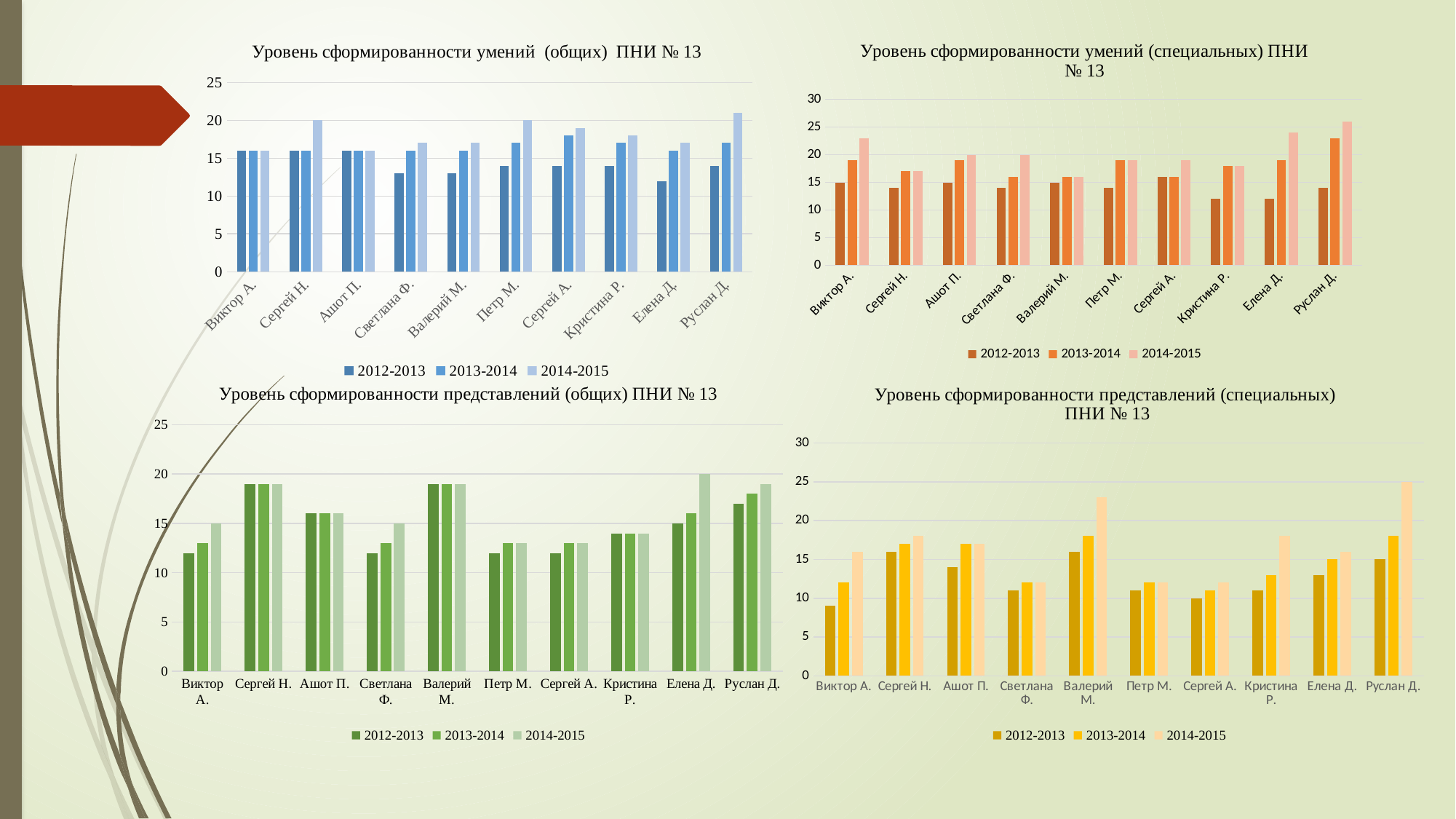
How many series does the legend of the top-right chart "Уровень сформированности умений (специальных) ПНИ № 13" list? 3 What are the three legend entries of the bottom-left chart "Уровень сформированности представлений (общих) ПНИ № 13"? 2012-2013, 2013-2014, 2014-2015 In the top-right chart "Уровень сформированности умений (специальных) ПНИ № 13", is the 2014-2015 value for Руслан Д. greater or less than 25? greater What kind of chart is the top-left chart titled "Уровень сформированности умений (общих) ПНИ № 13"? Bar chart In the bottom-right chart "Уровень сформированности представлений (специальных) ПНИ № 13", is the 2014-2015 value for Валерий М. greater or less than 20? greater In the bottom-right chart "Уровень сформированности представлений (специальных) ПНИ № 13", which person has the highest 2014-2015 value? Руслан Д. In the bottom-right chart "Уровень сформированности представлений (специальных) ПНИ № 13", is the 2012-2013 value for Виктор А. greater or less than 10? less In the top-right chart "Уровень сформированности умений (специальных) ПНИ № 13", do the values for Руслан Д. rise or fall from 2012-2013 to 2014-2015? rise In the top-right chart "Уровень сформированности умений (специальных) ПНИ № 13", which person has the highest 2014-2015 value? Руслан Д. In the bottom-left chart "Уровень сформированности представлений (общих) ПНИ № 13", which is larger: the 2014-2015 value for Елена Д. or the 2014-2015 value for Петр М.? Елена Д. How many people (categories) are shown on the x axis of the bottom-left chart "Уровень сформированности представлений (общих) ПНИ № 13"? 10